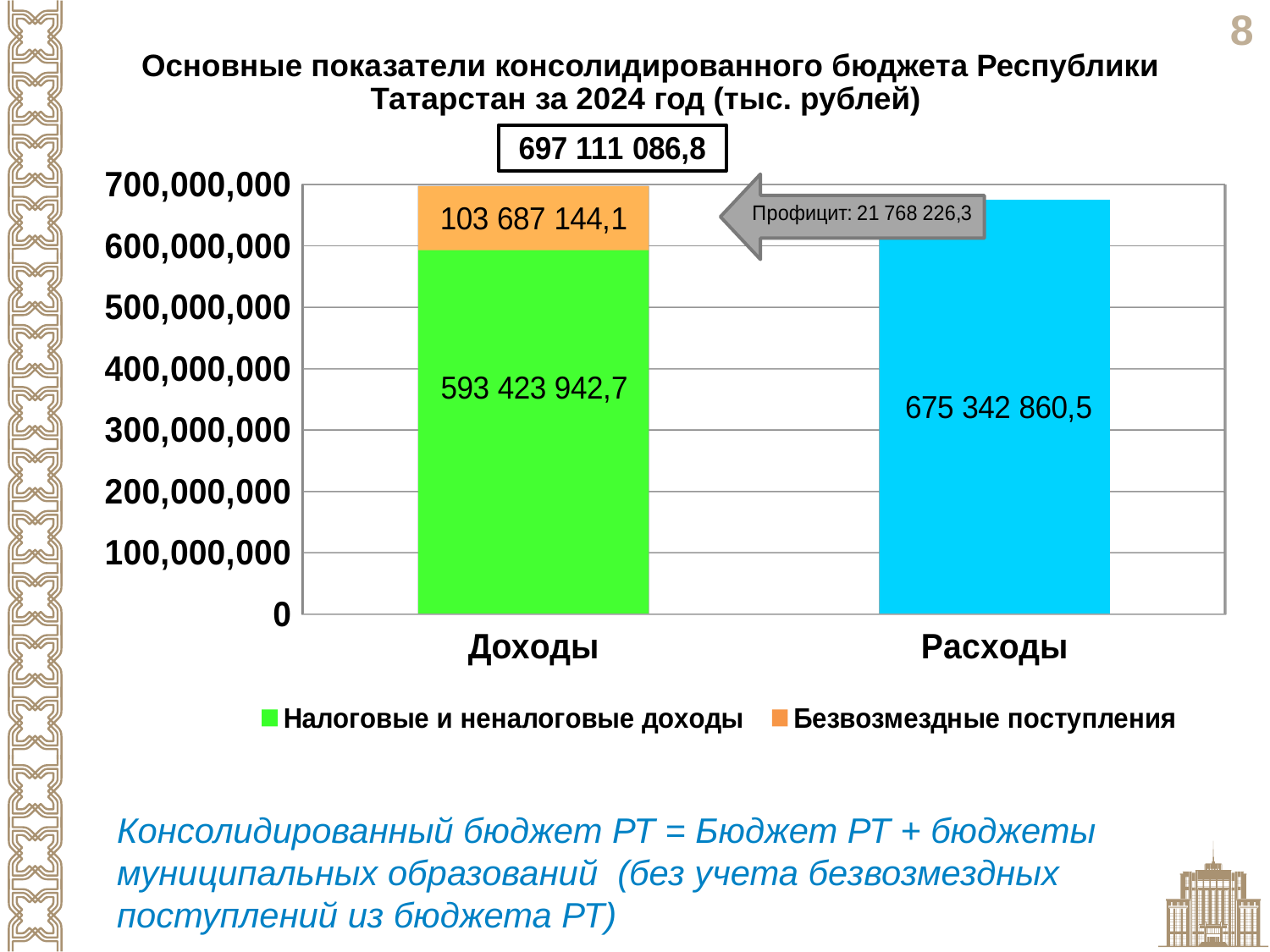
Is the value for 'Расходы' greater or less than 600,000,000? greater How many categories are shown on the x axis? 2 What is the total of the stacked 'Доходы' bar? 697 111 086,8 What is the value of the 'Безвозмездные поступления' segment in the 'Доходы' bar? 103 687 144,1 Is the 'Безвозмездные поступления' segment greater or less than 200,000,000? less How many series does the legend list? 2 What is the value of the 'Налоговые и неналоговые доходы' segment in the 'Доходы' bar? 593 423 942,7 What kind of chart is shown on the slide? Stacked bar chart What is the difference between the 'Налоговые и неналоговые доходы' segment and the 'Безвозмездные поступления' segment in the 'Доходы' bar? 489 736 798,6 What surplus (Профицит) value is shown in the arrow on the chart? 21 768 226,3 Which is larger: the total 'Доходы' bar or the 'Расходы' bar? Доходы What is the value shown for 'Расходы'? 675 342 860,5